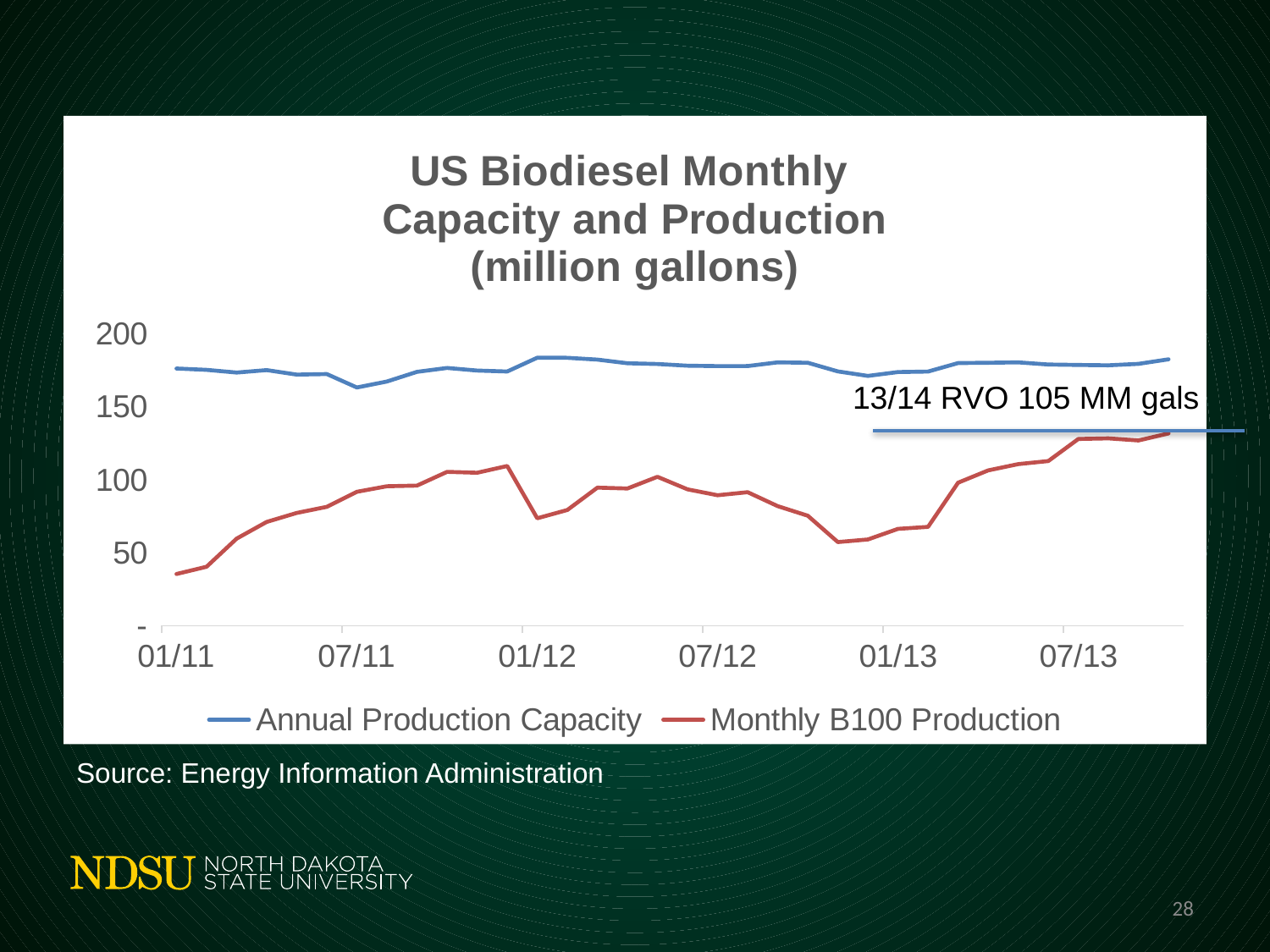
Does Monthly B100 Production rise or fall between 01/13 and 07/13? rise Is the value for Monthly B100 Production at 01/12 greater or less than 100? less Does Monthly B100 Production rise or fall between 01/11 and 07/11? rise Is the value for Annual Production Capacity at 01/11 greater or less than 150? greater At 01/11, which series has the higher value, Annual Production Capacity or Monthly B100 Production? Annual Production Capacity Is the value for Annual Production Capacity at 07/11 greater or less than 150? greater How many series does the legend list? 2 Which series is drawn in red? Monthly B100 Production What is the title of the chart? US Biodiesel Monthly Capacity and Production (million gallons) What kind of chart is shown on the slide? line chart